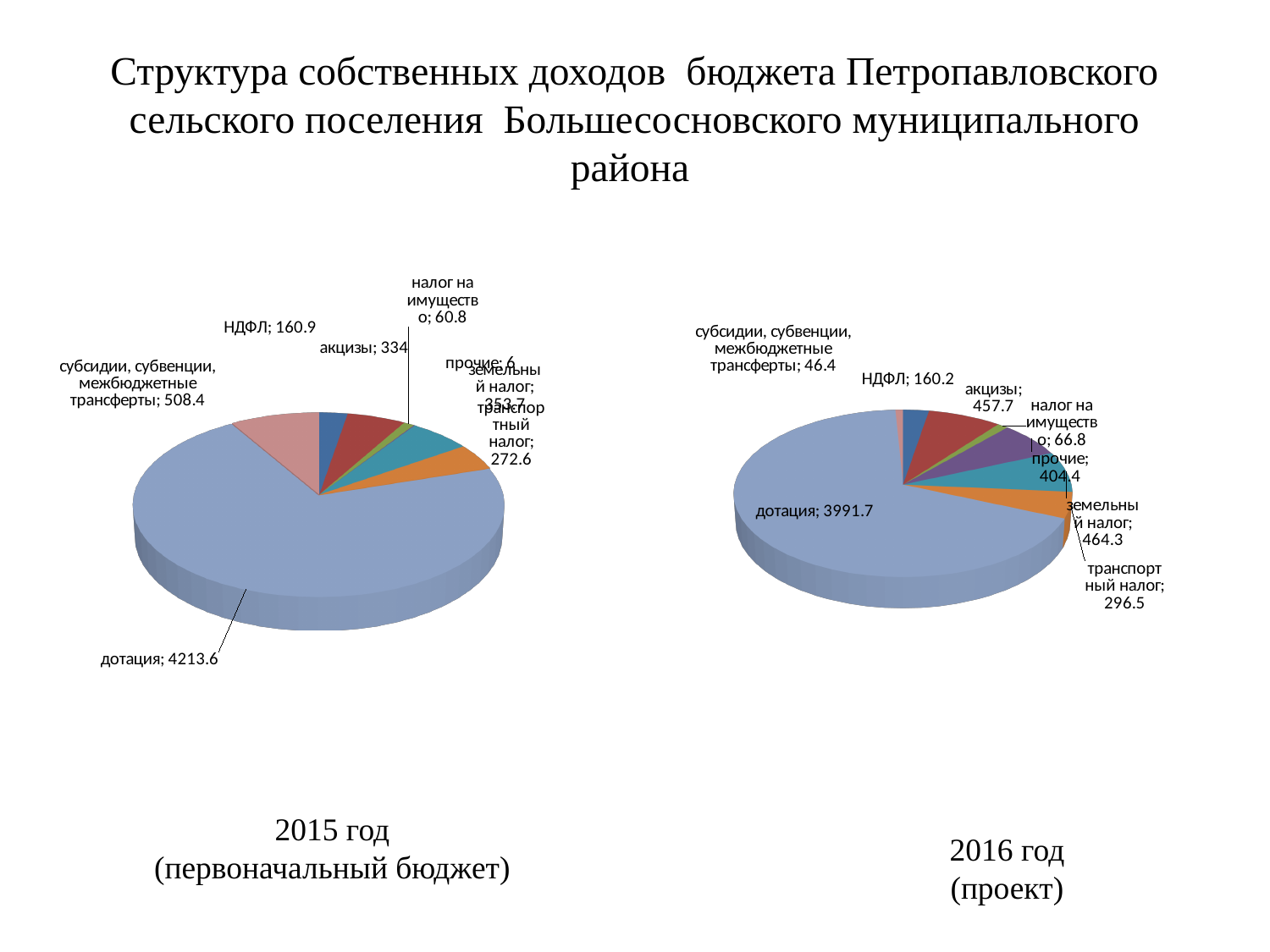
In the 2015 год chart, which category has the largest slice? дотация By how much is дотация in the 2015 год chart larger than дотация in the 2016 год chart? 221.9 In the 2015 год chart, what is the value for субсидии, субвенции, межбюджетные трансферты? 508.4 In the 2015 год chart, what is the value for транспортный налог? 272.6 In the 2016 год (проект) chart, what is the value for дотация? 3991.7 In the 2016 год chart, which category has the smallest value? субсидии, субвенции, межбюджетные трансферты How many categories are shown in the 2016 год (проект) pie chart? 8 In the 2016 год chart, what is the value for акцизы? 457.7 What kind of chart is used on this slide for the 2015 and 2016 budgets? Pie chart In the 2016 год chart, which is larger: транспортный налог or НДФЛ? транспортный налог In the 2016 год chart, what is the difference between акцизы and НДФЛ? 297.5 In the 2015 год (первоначальный бюджет) chart, what is the value for дотация? 4213.6